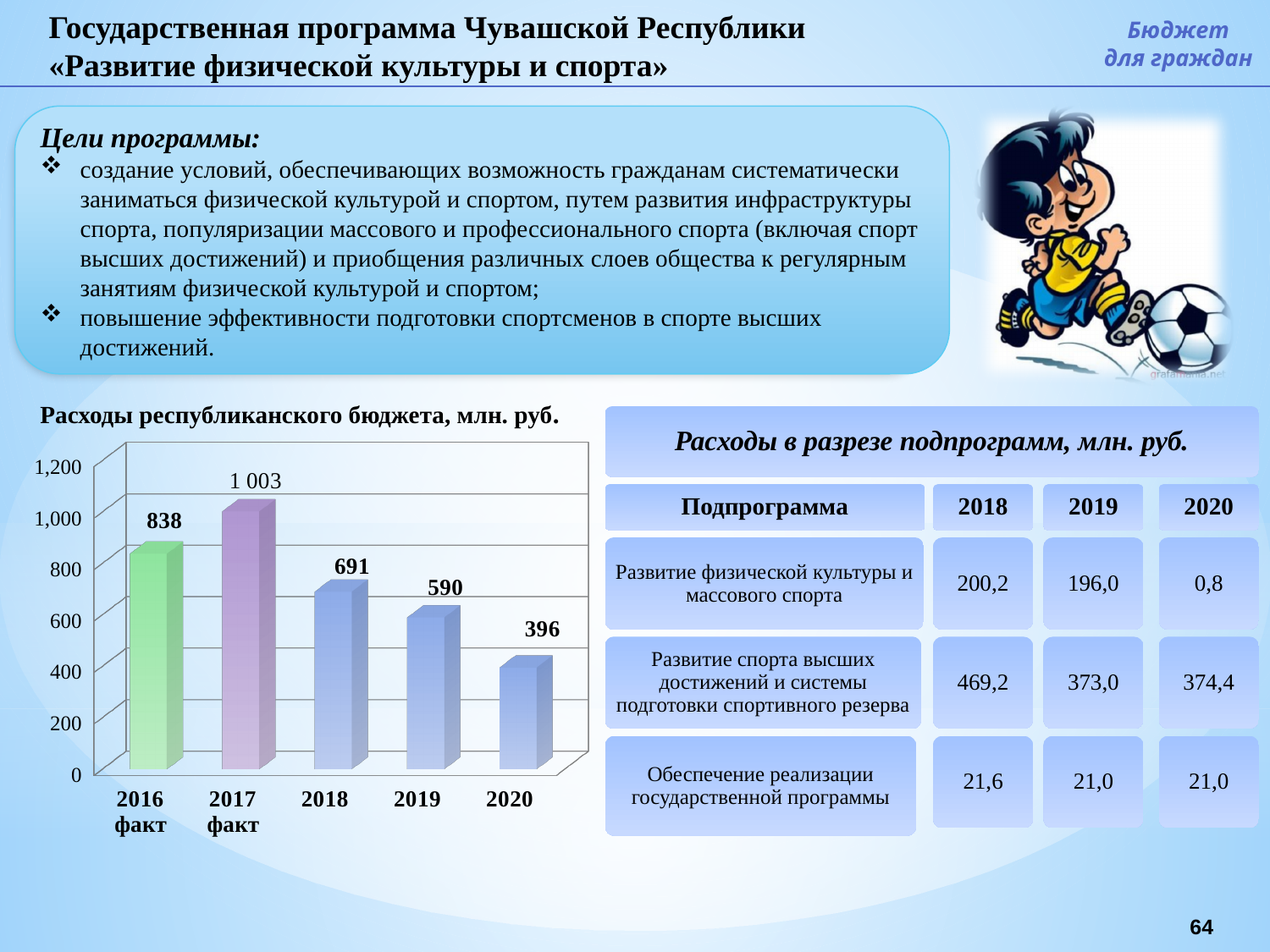
In the chart 'Расходы республиканского бюджета, млн. руб.', which is larger: the value for 2016 факт or the value for 2018? 2016 факт Which year has the lowest value in the chart 'Расходы республиканского бюджета, млн. руб.'? 2020 How many years are shown in the chart 'Расходы республиканского бюджета, млн. руб.'? 5 What is the value for 2020 in the chart 'Расходы республиканского бюджета, млн. руб.'? 396 In the chart 'Расходы республиканского бюджета, млн. руб.', is the value for 2019 greater or less than 600? less Which year has the highest value in the chart 'Расходы республиканского бюджета, млн. руб.'? 2017 факт In the chart 'Расходы республиканского бюджета, млн. руб.', what is the difference between the values for 2018 and 2019? 101 In the chart 'Расходы республиканского бюджета, млн. руб.', what is the difference between the values for 2016 факт and 2020? 442 What is the value for 2017 факт in the chart 'Расходы республиканского бюджета, млн. руб.'? 1 003 In the chart 'Расходы республиканского бюджета, млн. руб.', do the values rise or fall from 2017 факт to 2020? fall What kind of chart is 'Расходы республиканского бюджета, млн. руб.'? bar chart What is the value for 2018 in the chart 'Расходы республиканского бюджета, млн. руб.'? 691